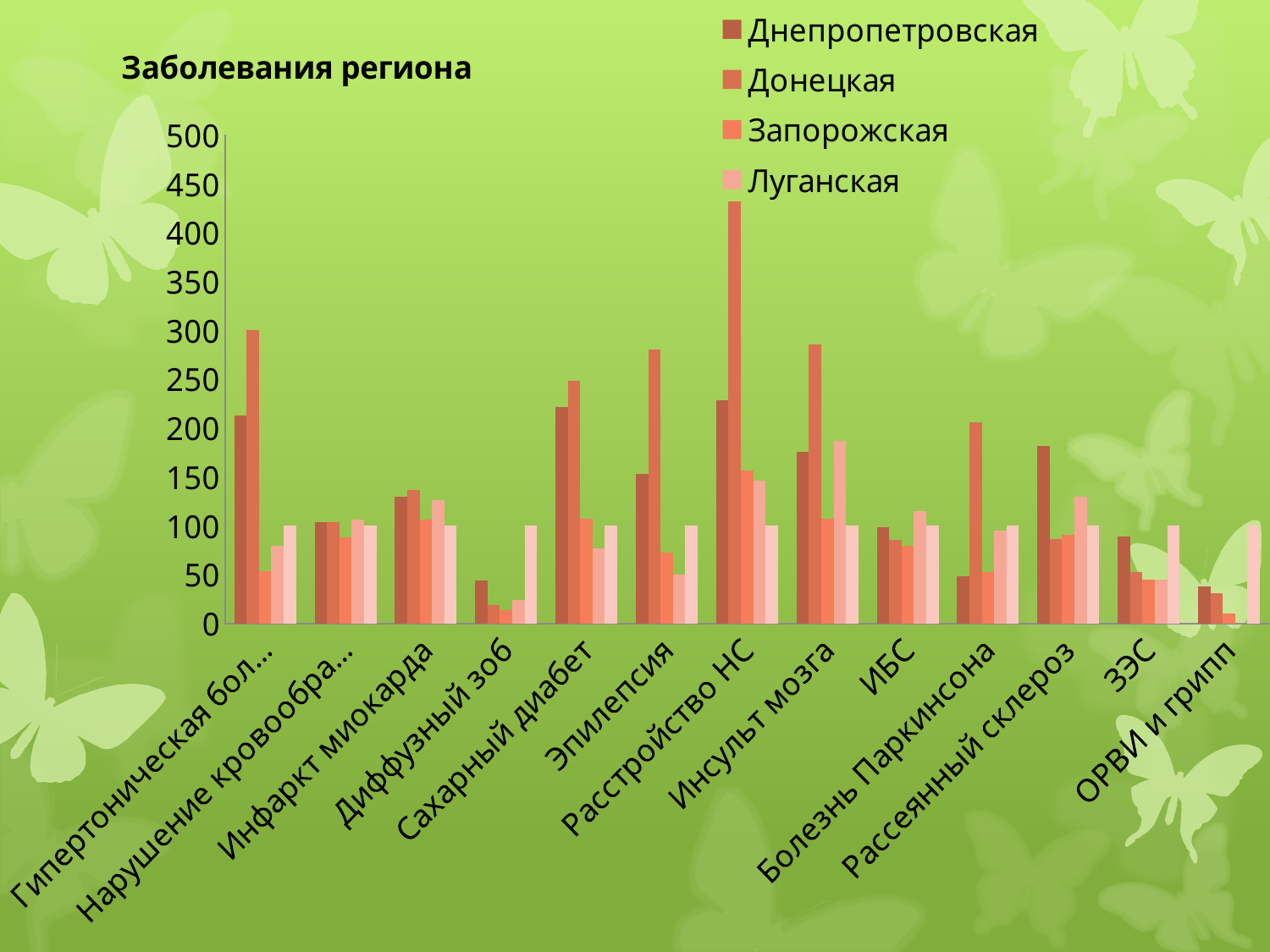
How many series does the legend list? 4 Is the Днепропетровская value for Диффузный зоб greater or less than 100? less Is the Донецкая value for Расстройство НС greater or less than 400? greater For Гипертоническая бол..., which is larger: the Днепропетровская value or the Донецкая value? Донецкая For the Днепропетровская series, which is larger: the value for Сахарный диабет or the value for Эпилепсия? Сахарный диабет Is the Запорожская value for ОРВИ и грипп greater or less than 50? less Which series is listed last in the legend? Луганская What kind of chart is shown on the slide? bar chart Which category has the highest value for the Донецкая series? Расстройство НС What is the title of the chart? Заболевания региона How many disease categories are shown on the x axis? 13